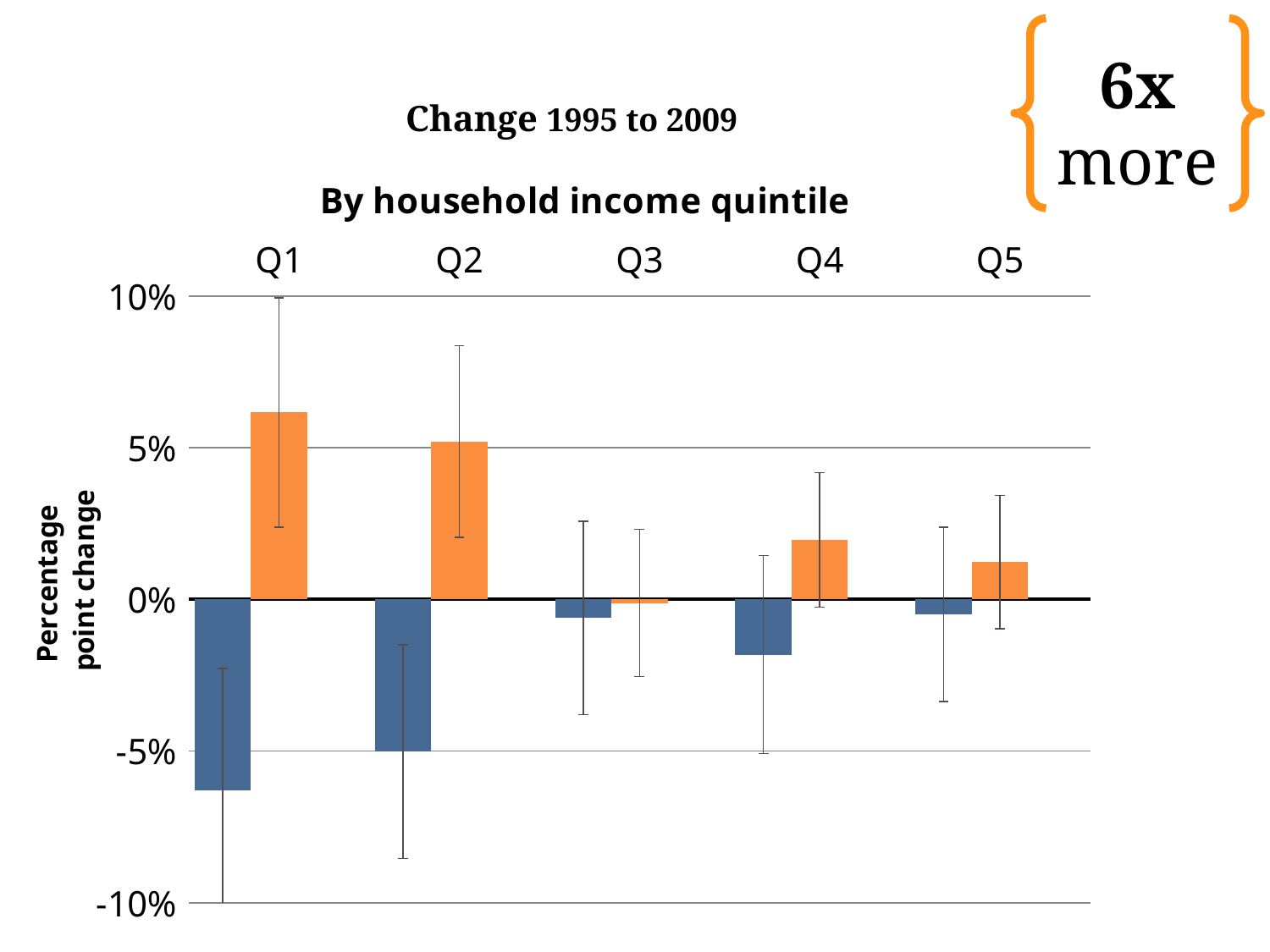
Which is larger, the orange bar for Q1 or the orange bar for Q4? Q1 Is the blue bar for Q4 greater or less than -5%? greater Is the blue bar for Q1 greater or less than -5%? less What is the title of the chart? By household income quintile What is the label on the vertical axis? Percentage point change How many household income quintiles are shown on the x axis? 5 Is the orange bar for Q1 greater or less than 5%? greater Which quintile has the highest orange bar? Q1 Which is more negative, the blue bar for Q2 or the blue bar for Q5? Q2 What kind of chart is shown on the slide? Bar chart Which quintile has the lowest (most negative) blue bar? Q1